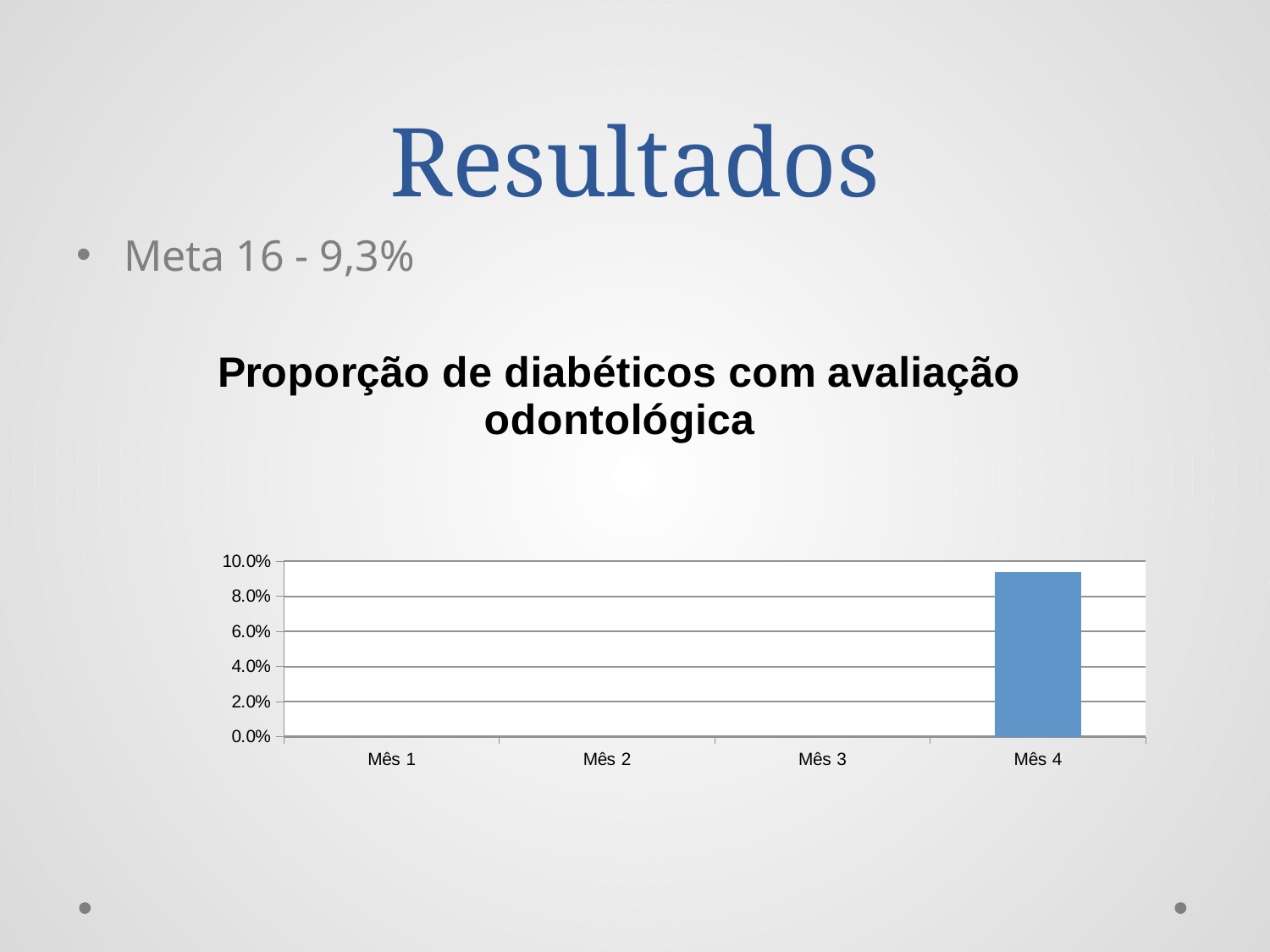
Which is larger, the value for Mês 2 or the value for Mês 4? Mês 4 What is the highest value shown on the y axis of the chart? 10.0% Is the value for Mês 3 greater or less than 2.0%? less What kind of chart is shown on the slide? bar chart How many categories are shown on the x axis of the chart? 4 Is the value for Mês 4 greater or less than 10.0%? less Is the value for Mês 4 greater or less than 8.0%? greater Which category has the highest value in the chart? Mês 4 What is the title of the chart? Proporção de diabéticos com avaliação odontológica Do the values rise or fall from Mês 3 to Mês 4? rise